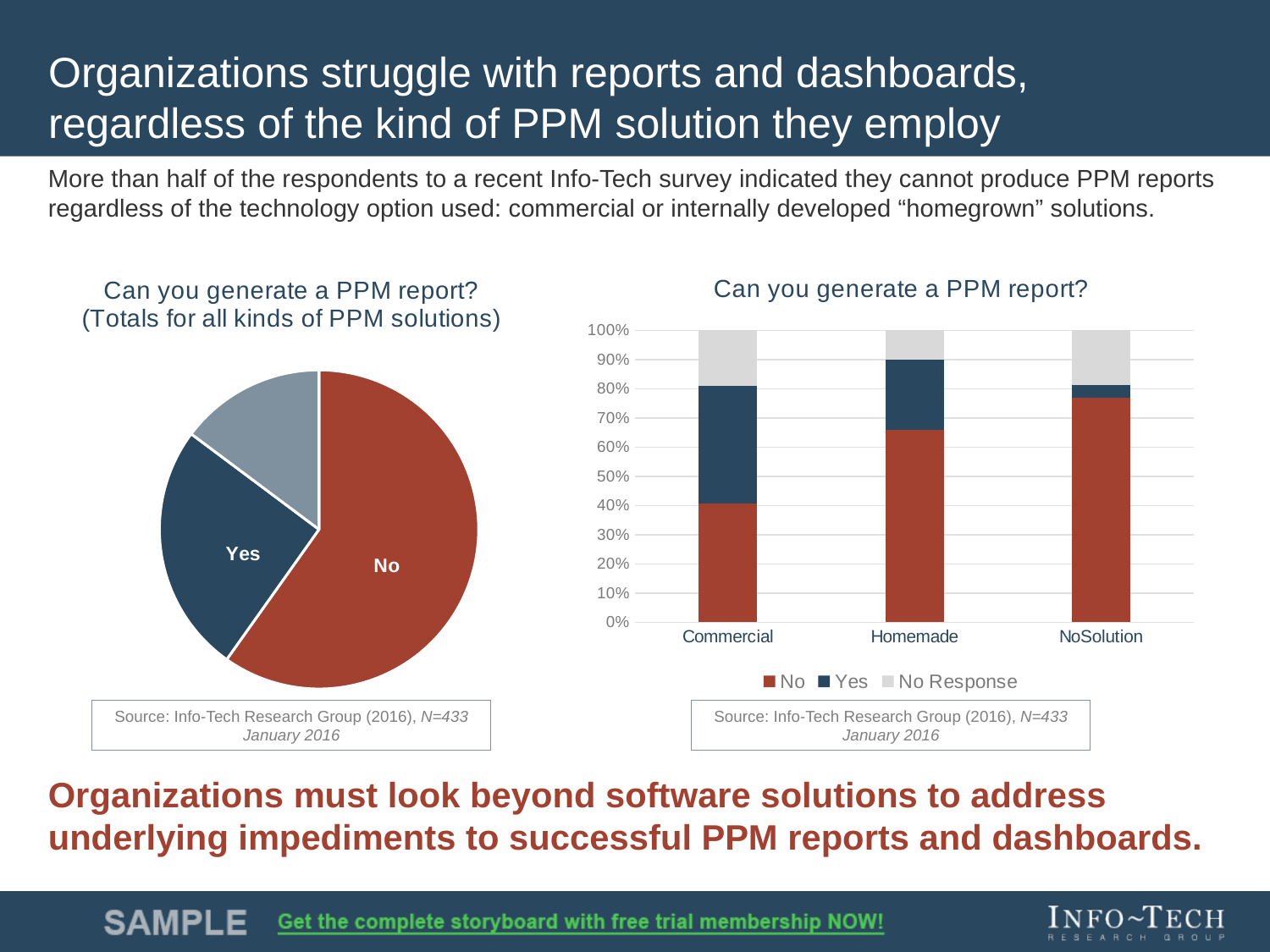
In the left pie chart, which is larger, the "Yes" slice or the "No" slice? No How many series does the legend of the right bar chart list? 3 What kind of chart is the left chart titled "Can you generate a PPM report? (Totals for all kinds of PPM solutions)"? Pie chart In the right bar chart, is the "No" value for Commercial greater or less than 50%? less In the left pie chart, which labelled slice is the largest? No What kind of chart is the right chart titled "Can you generate a PPM report?"? Stacked bar chart What are the three legend entries of the right bar chart? No, Yes, No Response How many categories are shown on the x axis of the right bar chart? 3 In the right bar chart, which category has the highest "No" share? NoSolution In the right bar chart, is the "No" value for Homemade greater or less than 60%? greater In the right bar chart, which category has the largest "Yes" segment? Commercial In the right bar chart, which category has the lowest "No" share? Commercial